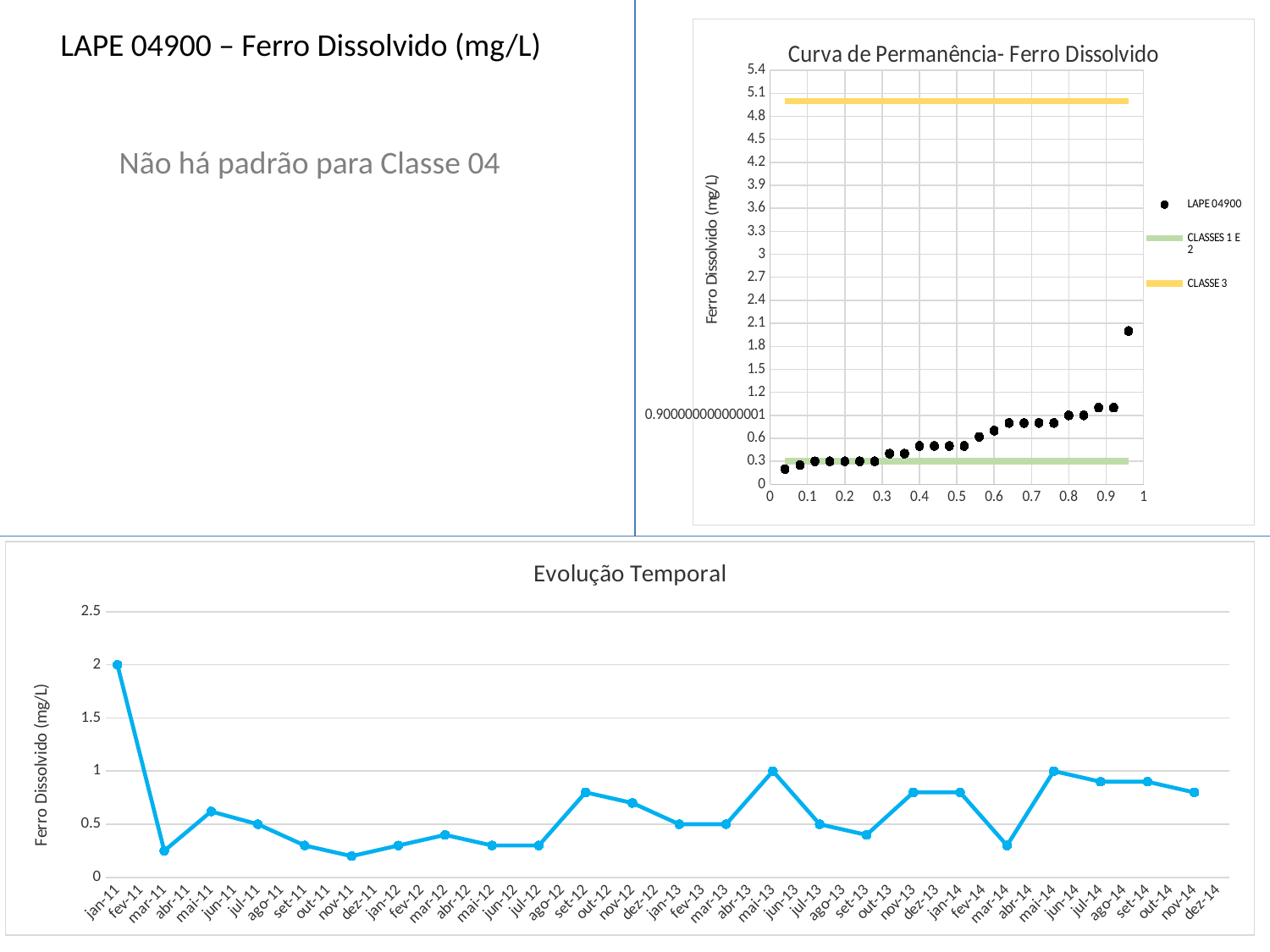
In the 'Evolução Temporal' chart, is the value for nov-11 greater or less than 0.5? less In the 'Evolução Temporal' chart, what is the value for jan-11? 2 In the 'Curva de Permanência- Ferro Dissolvido' chart, do the LAPE 04900 values rise or fall along the x axis? rise What is the y-axis label of the 'Curva de Permanência- Ferro Dissolvido' chart? Ferro Dissolvido (mg/L) In the 'Curva de Permanência- Ferro Dissolvido' chart, is the CLASSE 3 line greater or less than 4.8? greater How many series does the legend of the 'Curva de Permanência- Ferro Dissolvido' chart list? 3 In the 'Evolução Temporal' chart, is the value for set-12 greater or less than 0.5? greater In the 'Evolução Temporal' chart, which is larger, the value for mai-13 or the value for set-13? mai-13 What kind of chart is 'Evolução Temporal'? line chart In the 'Evolução Temporal' chart, which month has the highest dissolved iron value? jan-11 In the 'Evolução Temporal' chart, which month has the lowest dissolved iron value? nov-11 In the 'Evolução Temporal' chart, what is the value for mai-13? 1